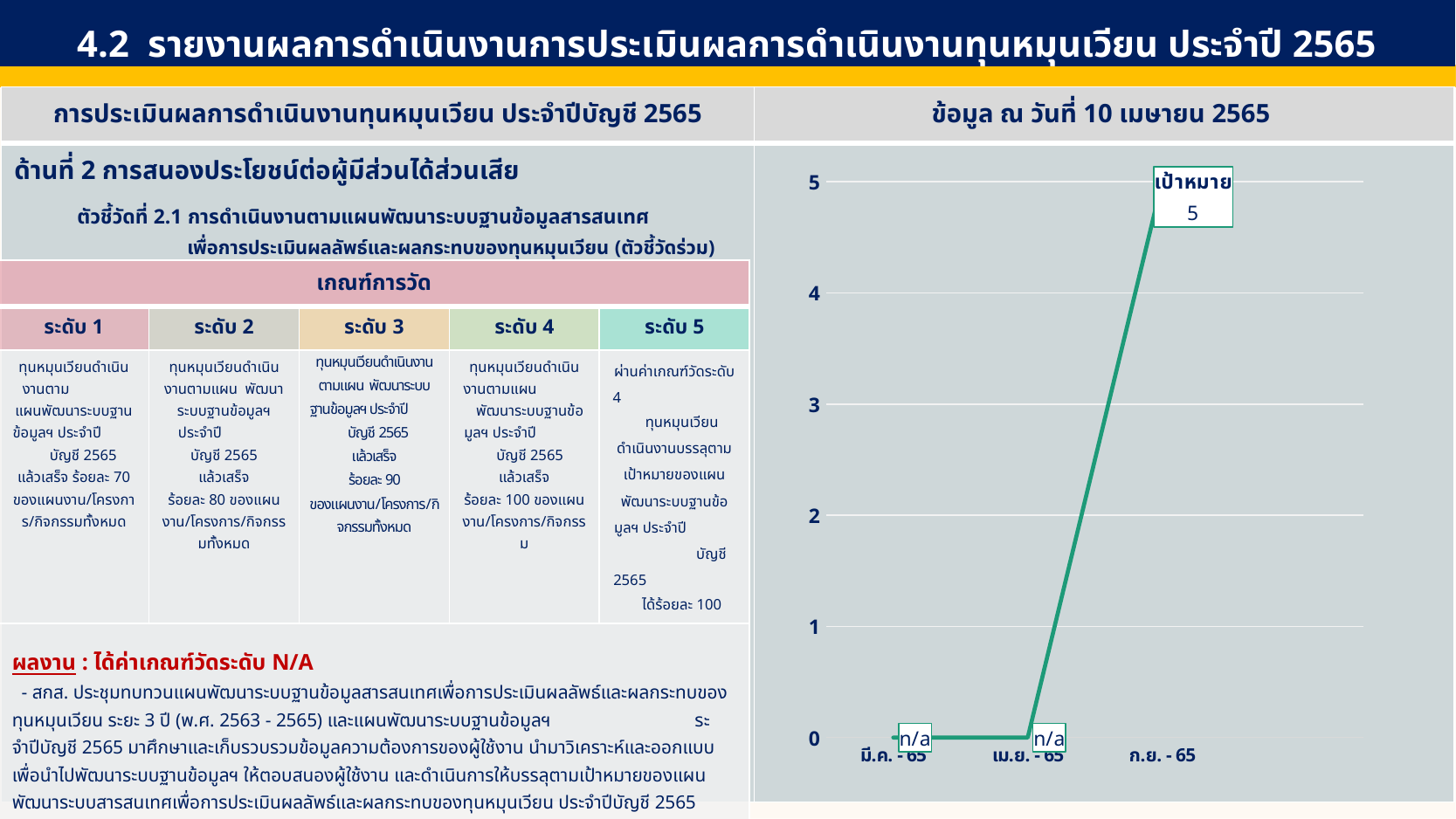
What is the highest tick value shown on the y-axis of the line chart? 5 Which is higher on the line chart, the point for เม.ย. - 65 or the point for ก.ย. - 65? ก.ย. - 65 Does the line rise or fall between เม.ย. - 65 and ก.ย. - 65? rises What value is labelled for ก.ย. - 65 on the line chart? 5 How many points (x-axis categories) are plotted on the line chart? 3 Is the value for ก.ย. - 65 greater or less than 4? greater What word appears in the label box above the highest point of the line chart? เป้าหมาย What data label is shown for มี.ค. - 65 on the line chart? n/a What kind of chart is shown on the right side of the slide? line chart What data label is shown for เม.ย. - 65 on the line chart? n/a Which x-axis category has the highest point on the line chart? ก.ย. - 65